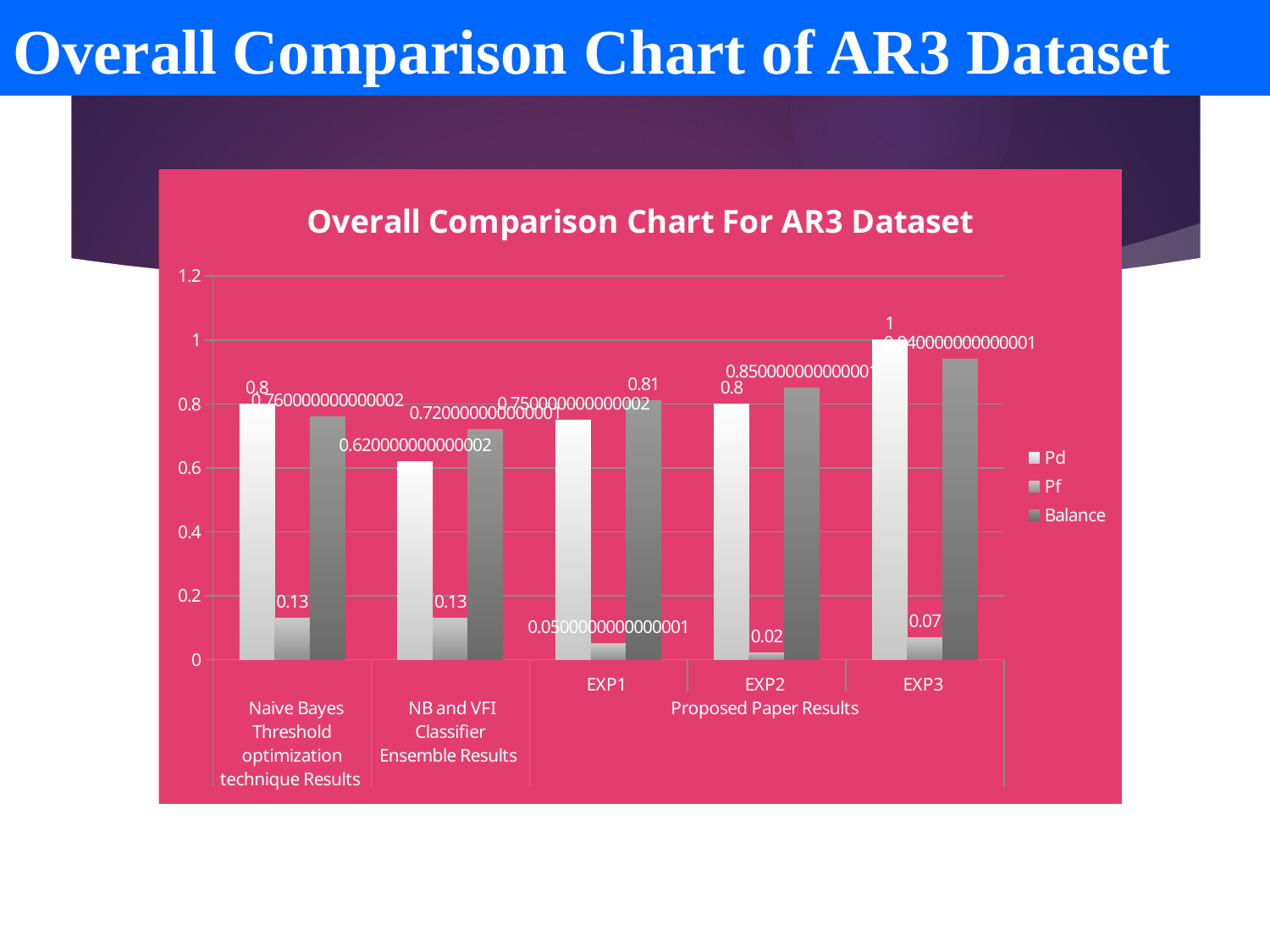
What is the Pd value for EXP3? 1 Which category has the highest Pd value? EXP3 What is the Pf value for the Naive Bayes Threshold optimization technique Results? 0.13 What kind of chart is shown on the slide? bar chart Which category has the lowest Pf value? EXP2 Is the Balance value for EXP3 greater or less than 0.8? greater What is the Balance value for EXP1? 0.81 What is the title of the chart? Overall Comparison Chart For AR3 Dataset Which is larger: the Pf value for the Naive Bayes Threshold optimization technique Results or the Pf value for EXP3? Naive Bayes Threshold optimization technique Results How many series does the legend list? 3 What is the difference between the Pd value for EXP3 and the Pd value for EXP2? 0.2 What is the Pf value for EXP2? 0.02